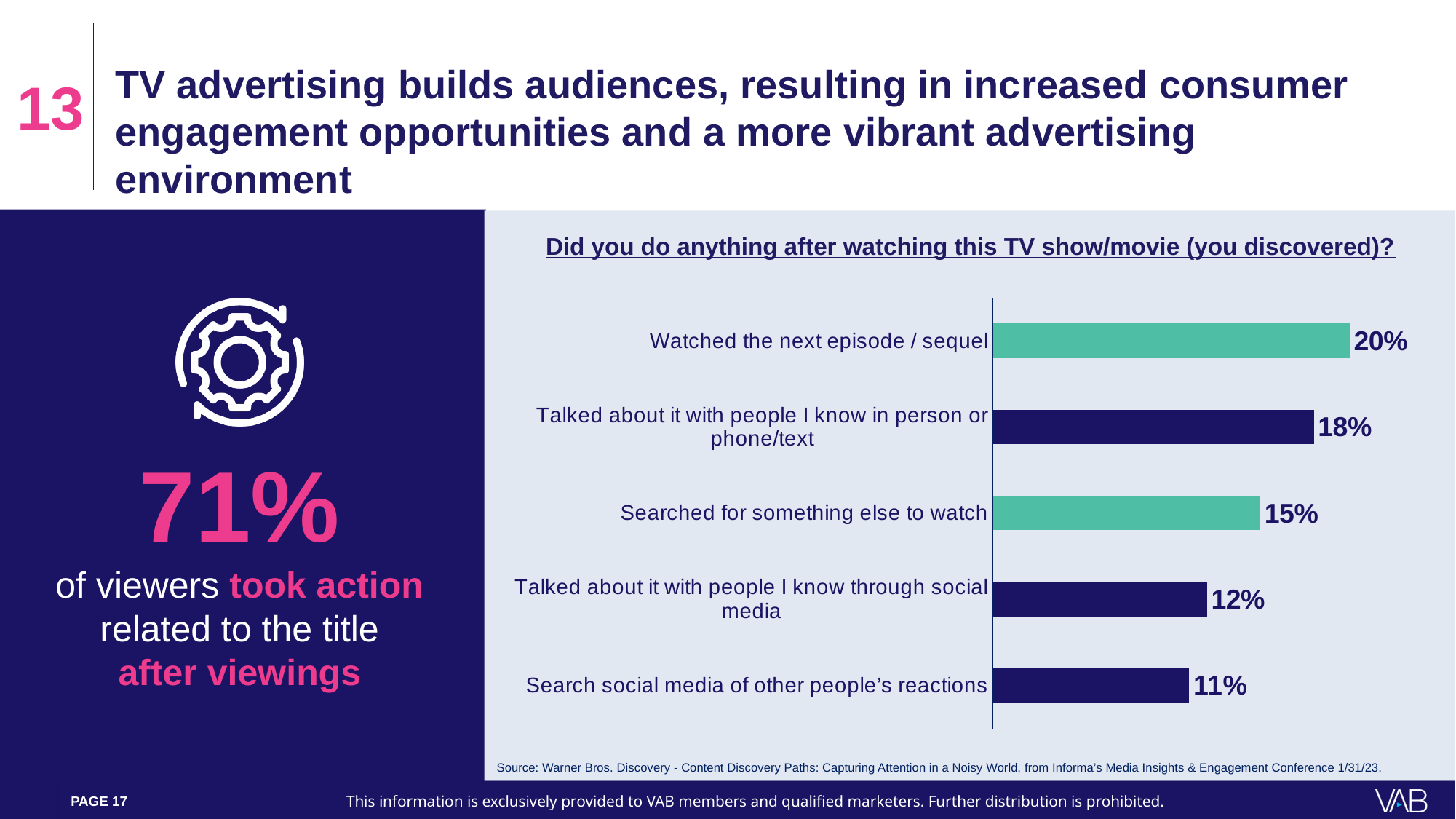
Which is larger: 'Talked about it with people I know in person or phone/text' or 'Talked about it with people I know through social media'? Talked about it with people I know in person or phone/text What kind of chart is shown on the slide? Bar chart Which category has the lowest value in the chart? Search social media of other people's reactions What is the difference between 'Searched for something else to watch' and 'Search social media of other people's reactions'? 4% What percentage talked about it with people they know through social media? 12% Which category has the highest value in the chart? Watched the next episode / sequel How many categories are shown in the chart? 5 What is the difference between 'Watched the next episode / sequel' and 'Talked about it with people I know in person or phone/text'? 2% What is the title of the chart? Did you do anything after watching this TV show/movie (you discovered)? What percentage of viewers took action related to the title after viewings, according to the callout on the left? 71% What percentage of respondents watched the next episode / sequel? 20% What is the value for 'Searched for something else to watch'? 15%